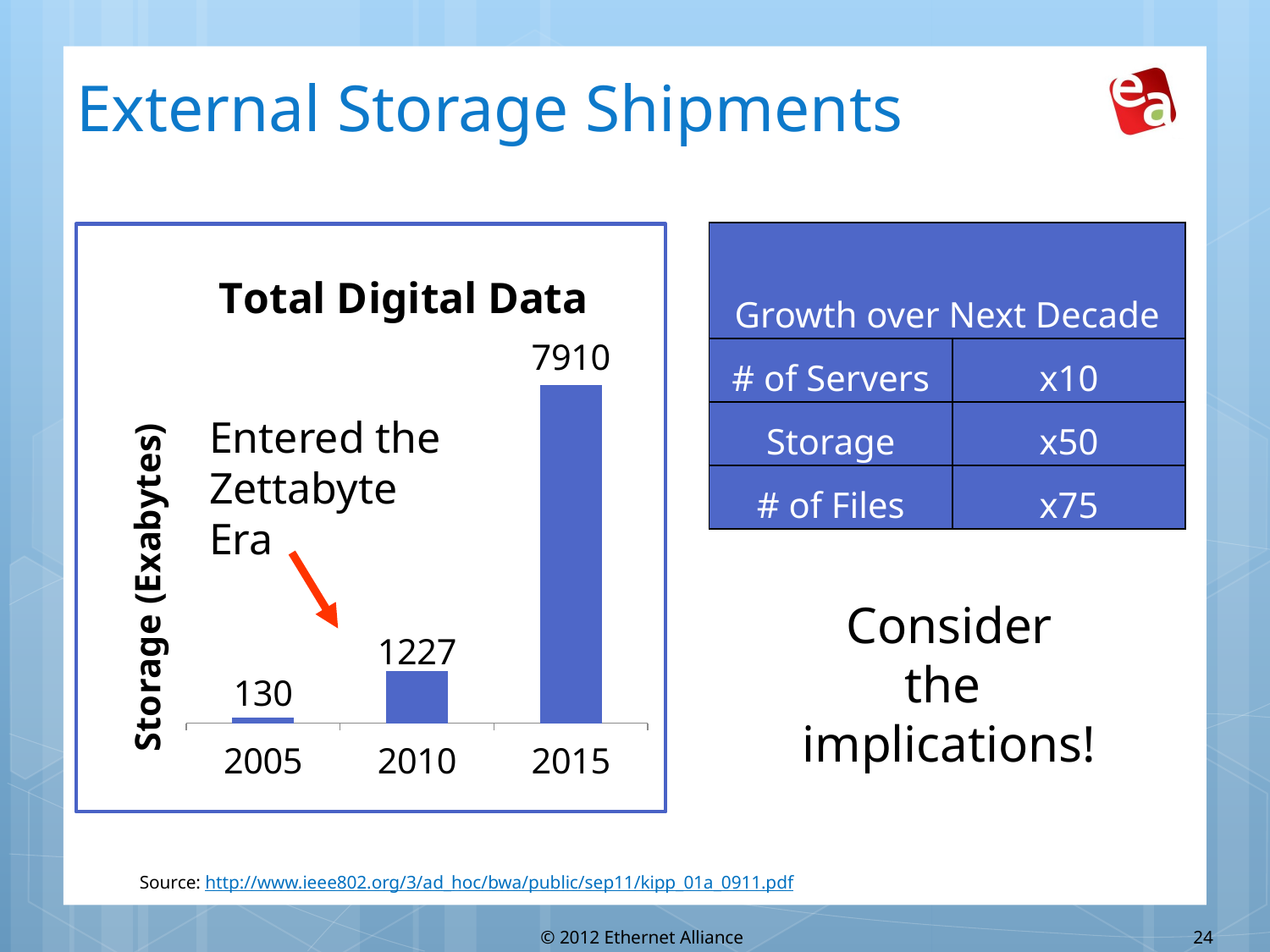
What is the value for 2010 in the Total Digital Data chart? 1227 Which is larger in the Total Digital Data chart, the value for 2010 or the value for 2005? 2010 What is the difference between the 2015 and 2010 values in the Total Digital Data chart? 6683 Which year has the lowest value in the Total Digital Data chart? 2005 What is the value for 2005 in the Total Digital Data chart? 130 What is the value for 2015 in the Total Digital Data chart? 7910 How many years are shown on the x axis of the Total Digital Data chart? 3 Which year has the highest value in the Total Digital Data chart? 2015 Do the values in the Total Digital Data chart rise or fall from 2005 to 2015? rise What kind of chart is the Total Digital Data chart? bar chart What is the difference between the 2010 and 2005 values in the Total Digital Data chart? 1097 What is the y-axis label of the Total Digital Data chart? Storage (Exabytes)